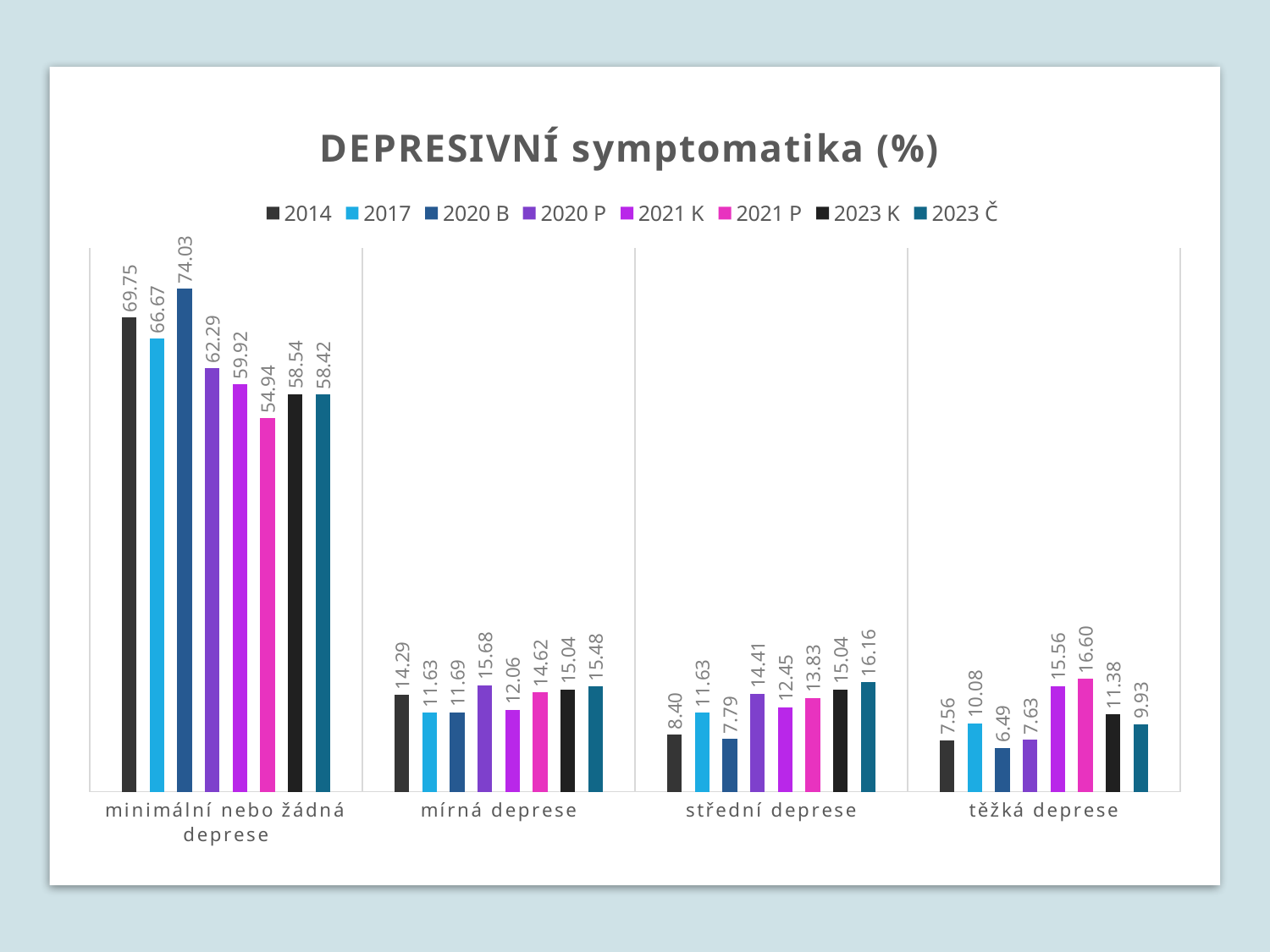
What is the difference between the 2014 and 2021 P values in the 'minimální nebo žádná deprese' category? 14.81 How many series does the legend list? 8 How many categories are shown on the x axis? 4 What is the value for 2020 B in the 'minimální nebo žádná deprese' category? 74.03 What is the value for 2023 Č in the 'střední deprese' category? 16.16 In the 'střední deprese' category, which is larger: the value for 2014 or the value for 2020 P? 2020 P What is the value for 2021 P in the 'těžká deprese' category? 16.60 What kind of chart is shown on the slide? bar chart What is the value for 2020 P in the 'mírná deprese' category? 15.68 Which series has the lowest value in the 'těžká deprese' category? 2020 B What is the title of the chart? DEPRESIVNÍ symptomatika (%) Which series has the highest value in the 'minimální nebo žádná deprese' category? 2020 B